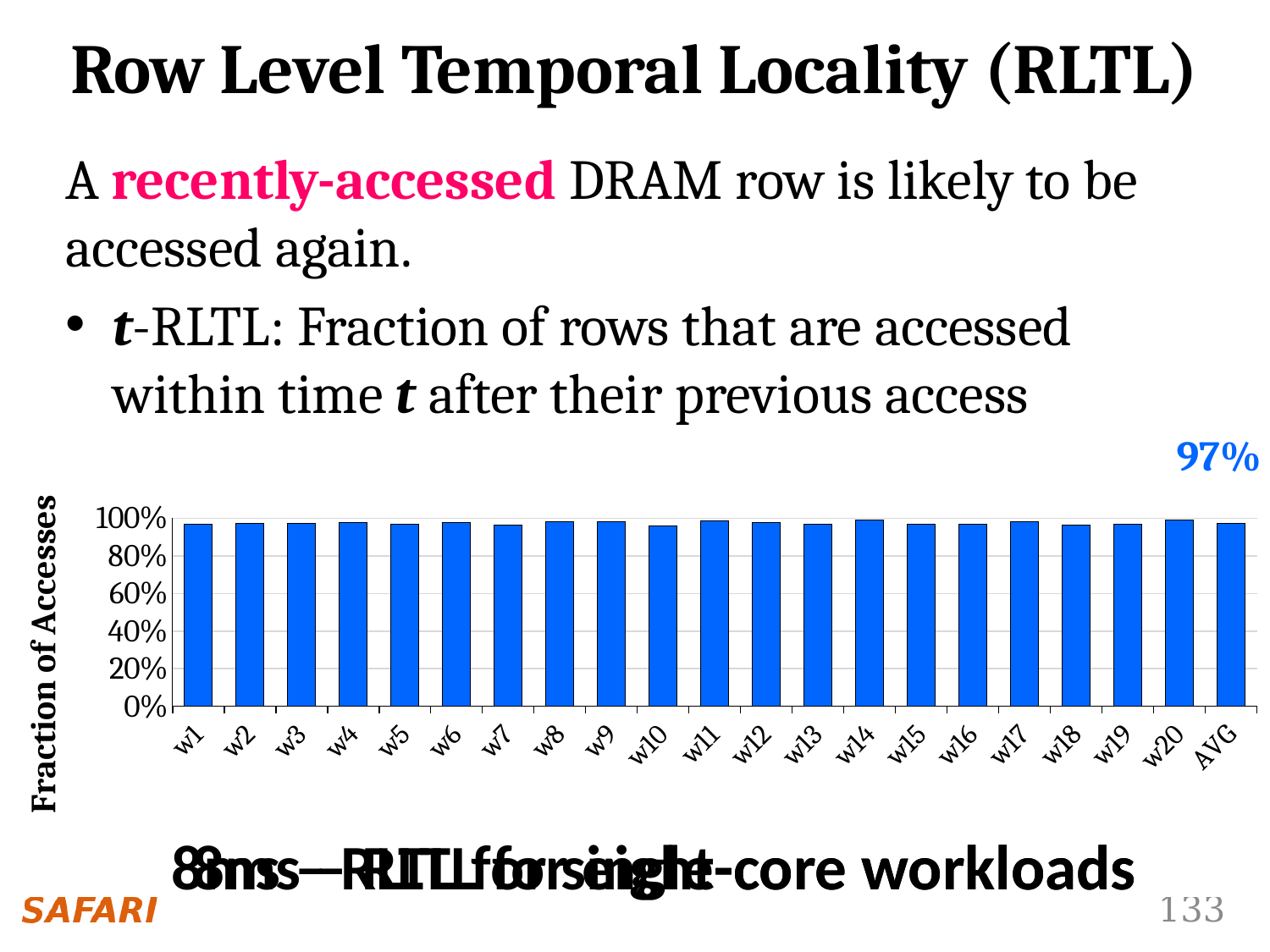
Is the value for w10 greater or less than 60%? greater Do the values rise, fall, or stay roughly flat from w1 to w20? roughly flat Is the value for w20 greater or less than 80%? greater What value is printed above the AVG bar? 97% What is the highest tick value shown on the y axis? 100% What kind of chart is shown on the slide? bar chart What is the label of the last category on the x axis? AVG Is the value for w1 greater or less than 80%? greater What is the label of the y axis of the chart? Fraction of Accesses How many categories are plotted along the x axis of the chart? 21